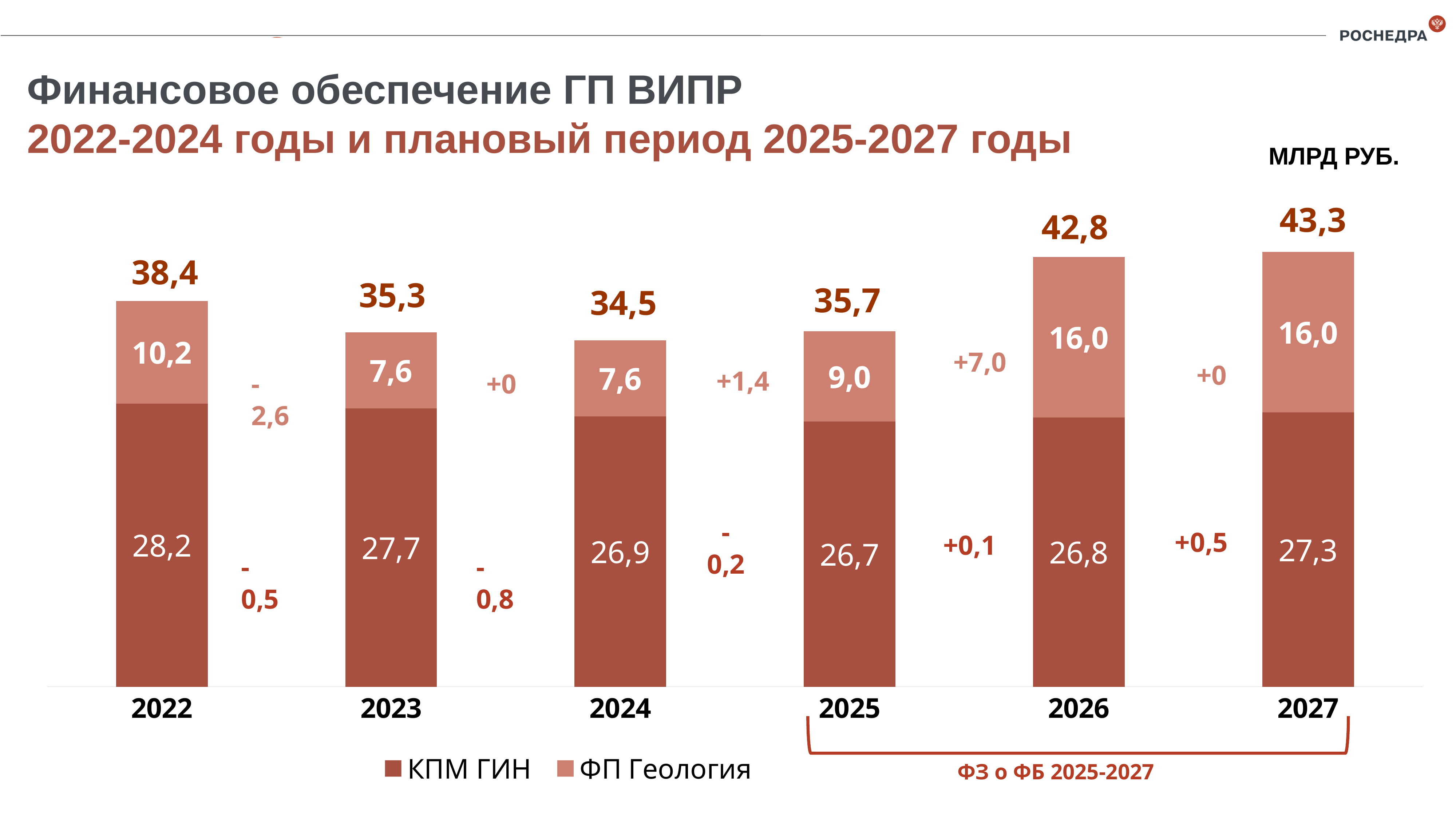
What is the value for ФП Геология in 2025? 9,0 How many years are shown on the x axis? 6 Which year has the highest total? 2027 What unit is indicated for the chart values? МЛРД РУБ. What is the total of the stacked bar for 2026? 42,8 Which year has the lowest total? 2024 What is the value for КПМ ГИН in 2022? 28,2 What is the difference between the ФП Геология values for 2026 and 2025? 7,0 Which year has the lowest КПМ ГИН value? 2025 What type of chart is shown on the slide? Stacked bar chart Which is larger: the КПМ ГИН value in 2022 or in 2027? 2022 How many series does the legend list? 2